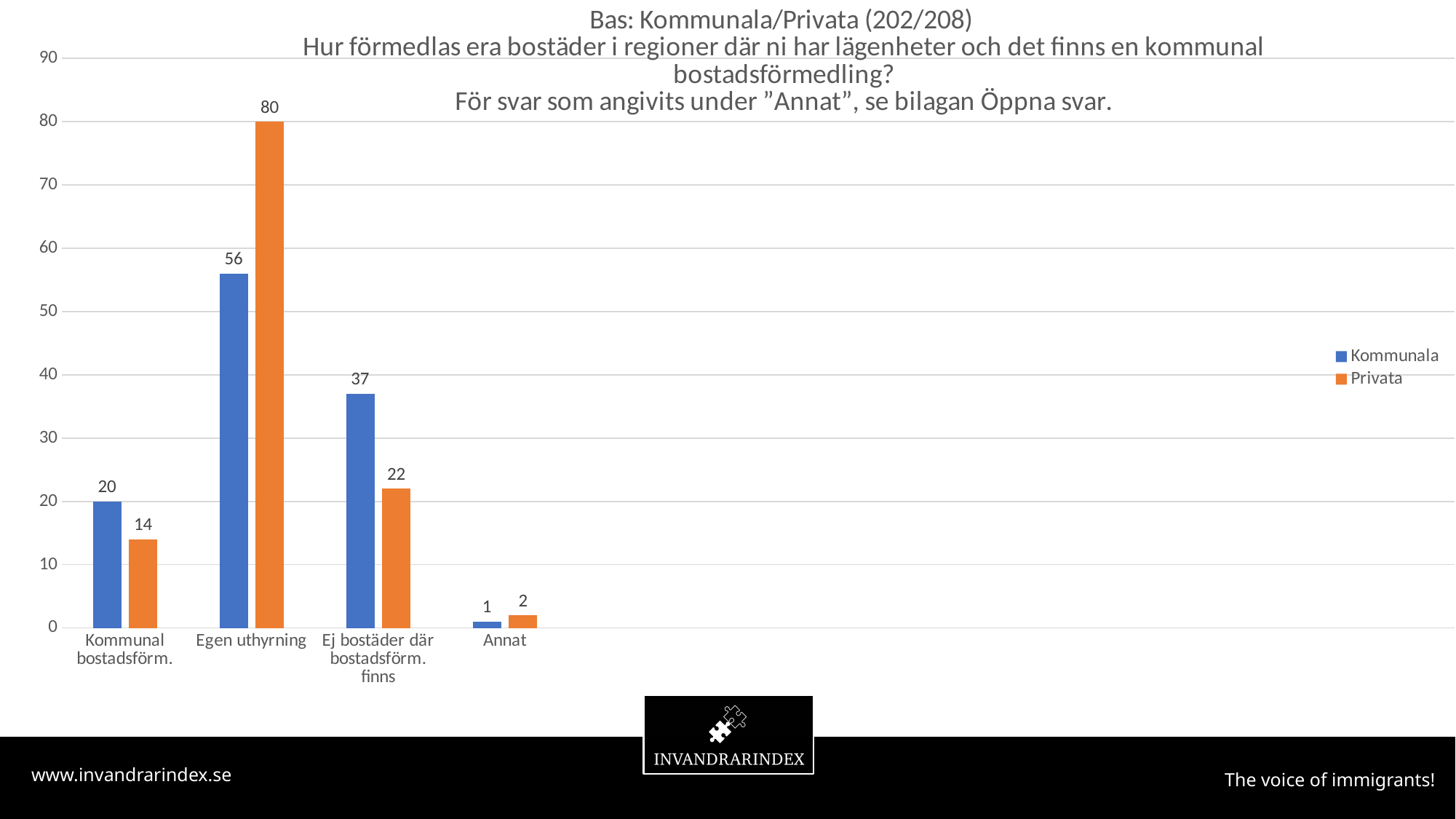
How many series does the legend list? 2 What is the difference between the Privata and Kommunala values in the Egen uthyrning category? 24 Which colour represents the Privata series? Orange How many categories are shown on the x axis? 4 Is the value for Kommunala in the Ej bostäder där bostadsförm. finns category greater or less than 30? greater Which is larger in the Ej bostäder där bostadsförm. finns category, Kommunala or Privata? Kommunala What kind of chart is shown on the slide? Bar chart Which category has the highest value for the Privata series? Egen uthyrning What is the value for Kommunala in the Egen uthyrning category? 56 What is the value for Privata in the Kommunal bostadsförm. category? 14 What is the value for Privata in the Annat category? 2 Which category has the lowest value for the Kommunala series? Annat